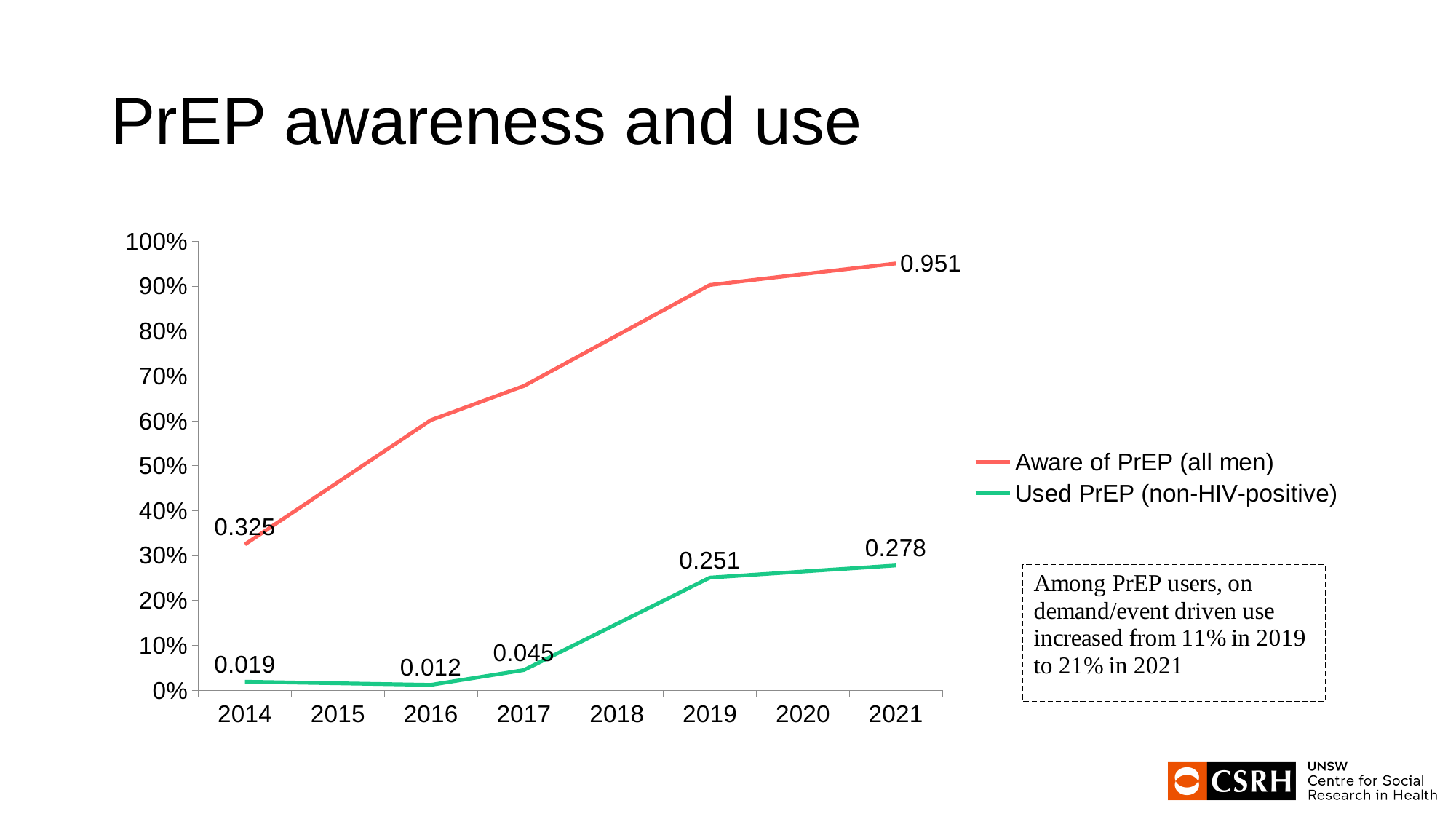
Does the Aware of PrEP (all men) line rise or fall from 2014 to 2021? rise Is the value for Aware of PrEP (all men) in 2019 greater or less than 80%? greater How many years are labelled on the x axis? 8 What is the value for Used PrEP (non-HIV-positive) in 2016? 0.012 What is the value for Used PrEP (non-HIV-positive) in 2019? 0.251 How many series does the legend list? 2 What is the value for Aware of PrEP (all men) in 2014? 0.325 By how much did the Used PrEP (non-HIV-positive) value increase from 2019 to 2021? 0.027 What is the value for Aware of PrEP (all men) in 2021? 0.951 In which year is the Used PrEP (non-HIV-positive) value lowest? 2016 What is the difference between the Aware of PrEP (all men) values in 2021 and 2014? 0.626 What kind of chart is shown on the slide? line chart